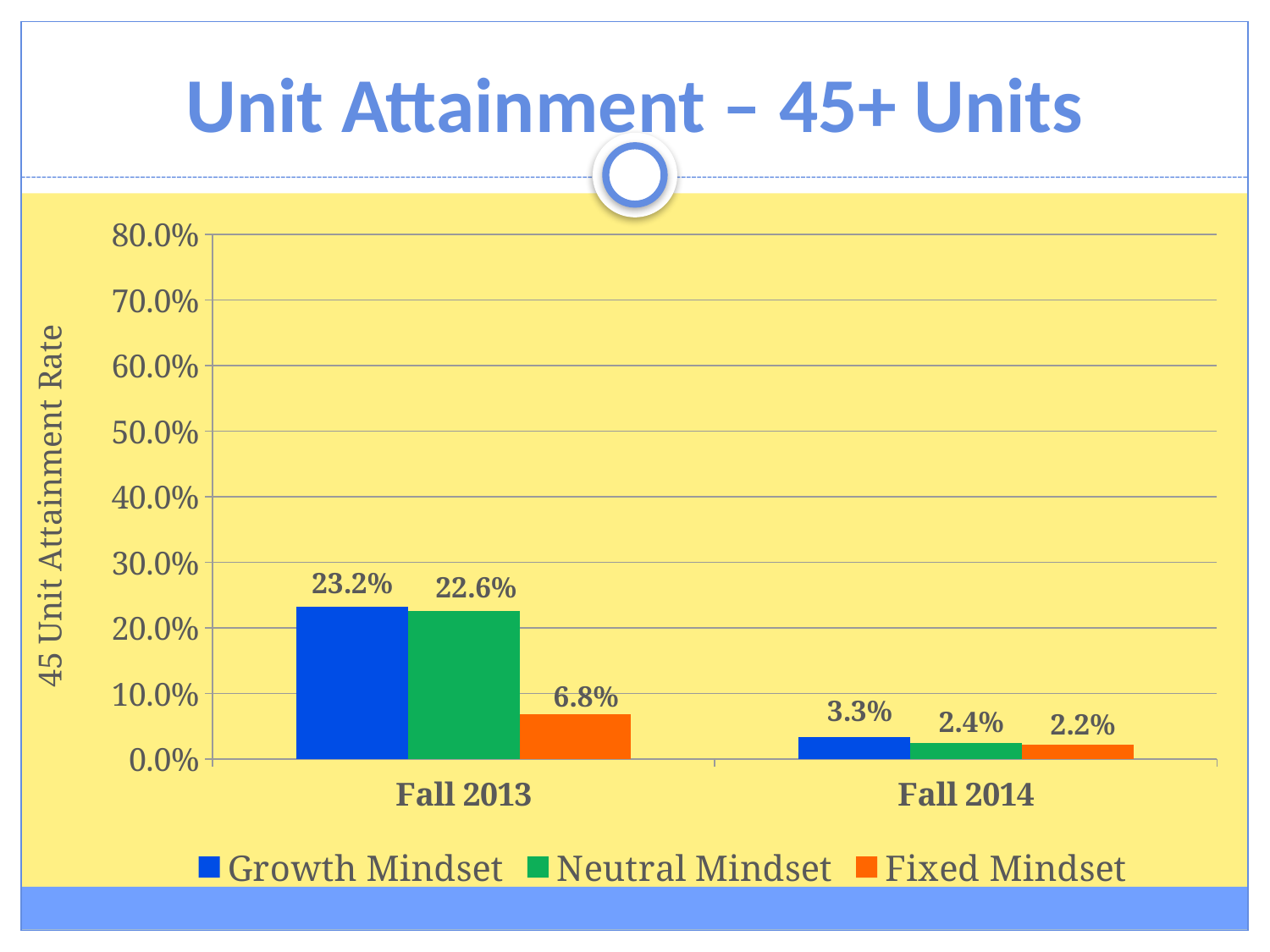
Do the Growth Mindset values rise or fall from Fall 2013 to Fall 2014? Fall Is the value for Growth Mindset in Fall 2013 greater or less than 20.0%? greater Which is larger: the Neutral Mindset value in Fall 2013 or the Fixed Mindset value in Fall 2013? Neutral Mindset in Fall 2013 Which mindset group has the lowest attainment rate in Fall 2013? Fixed Mindset What kind of chart is shown on the slide? Bar chart What is the 45 unit attainment rate for Growth Mindset in Fall 2013? 23.2% What is the 45 unit attainment rate for Fixed Mindset in Fall 2014? 2.2% What is the difference between the Growth Mindset values for Fall 2013 and Fall 2014? 19.9% What is the value for Neutral Mindset in Fall 2014? 2.4% What is the difference between the Growth Mindset and Fixed Mindset values in Fall 2013? 16.4% How many series does the legend list? 3 Which mindset group has the highest attainment rate in Fall 2013? Growth Mindset